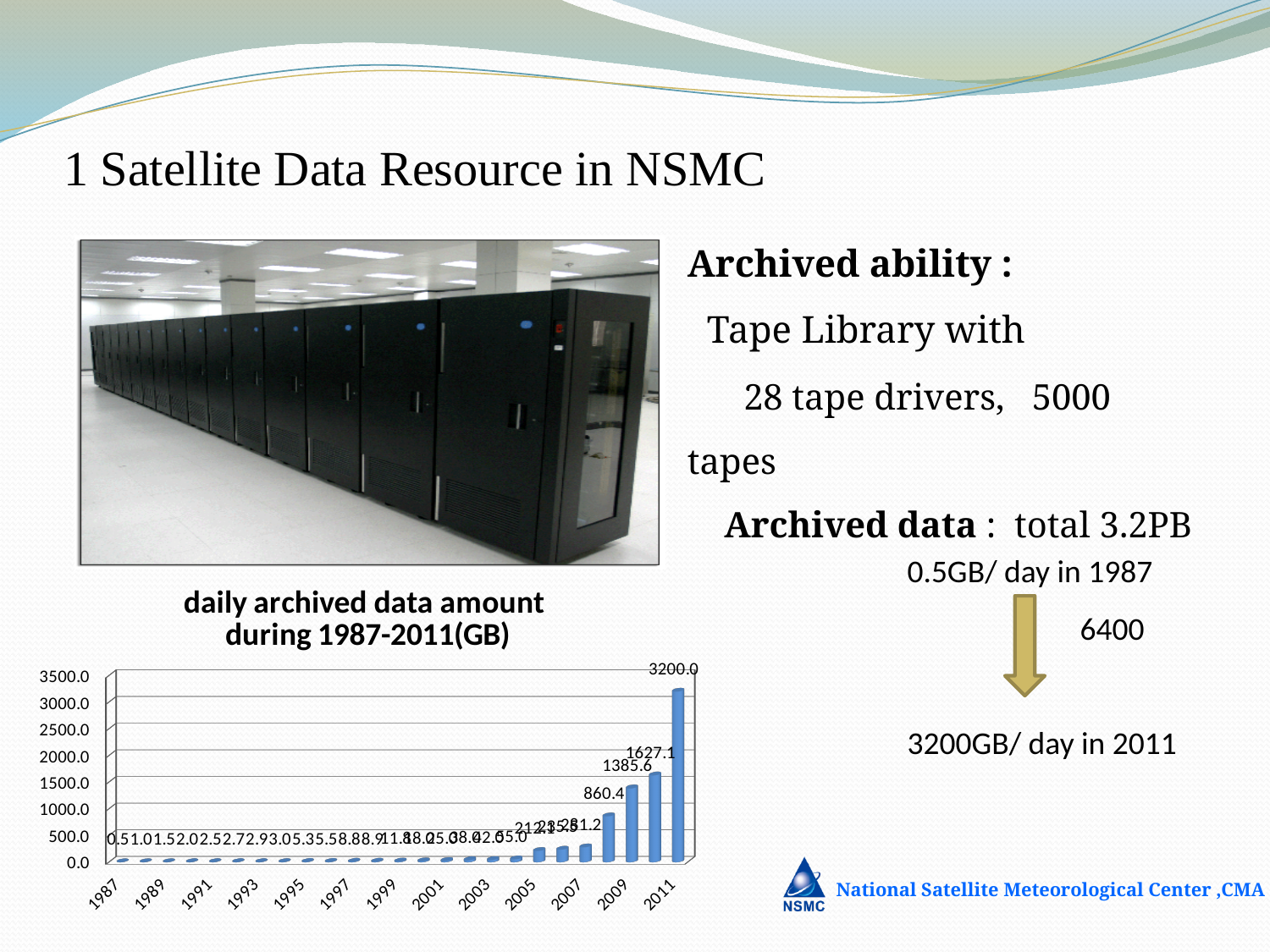
What is the title of the chart? daily archived data amount during 1987-2011(GB) What is the difference between the daily archived data amount in 2011 and in 2010? 1572.9 Which year has the lowest daily archived data amount? 1987 What is the daily archived data amount for 1987? 0.5 What is the daily archived data amount for 2011? 3200.0 Do the values generally rise or fall from 1987 to 2011? rise What kind of chart is shown on the slide? bar chart Which year has the larger daily archived data amount, 2008 or 2009? 2009 What is the daily archived data amount for 2008? 860.4 Which year has the highest daily archived data amount? 2011 What is the daily archived data amount for 2010? 1627.1 What is the daily archived data amount for 2009? 1385.6